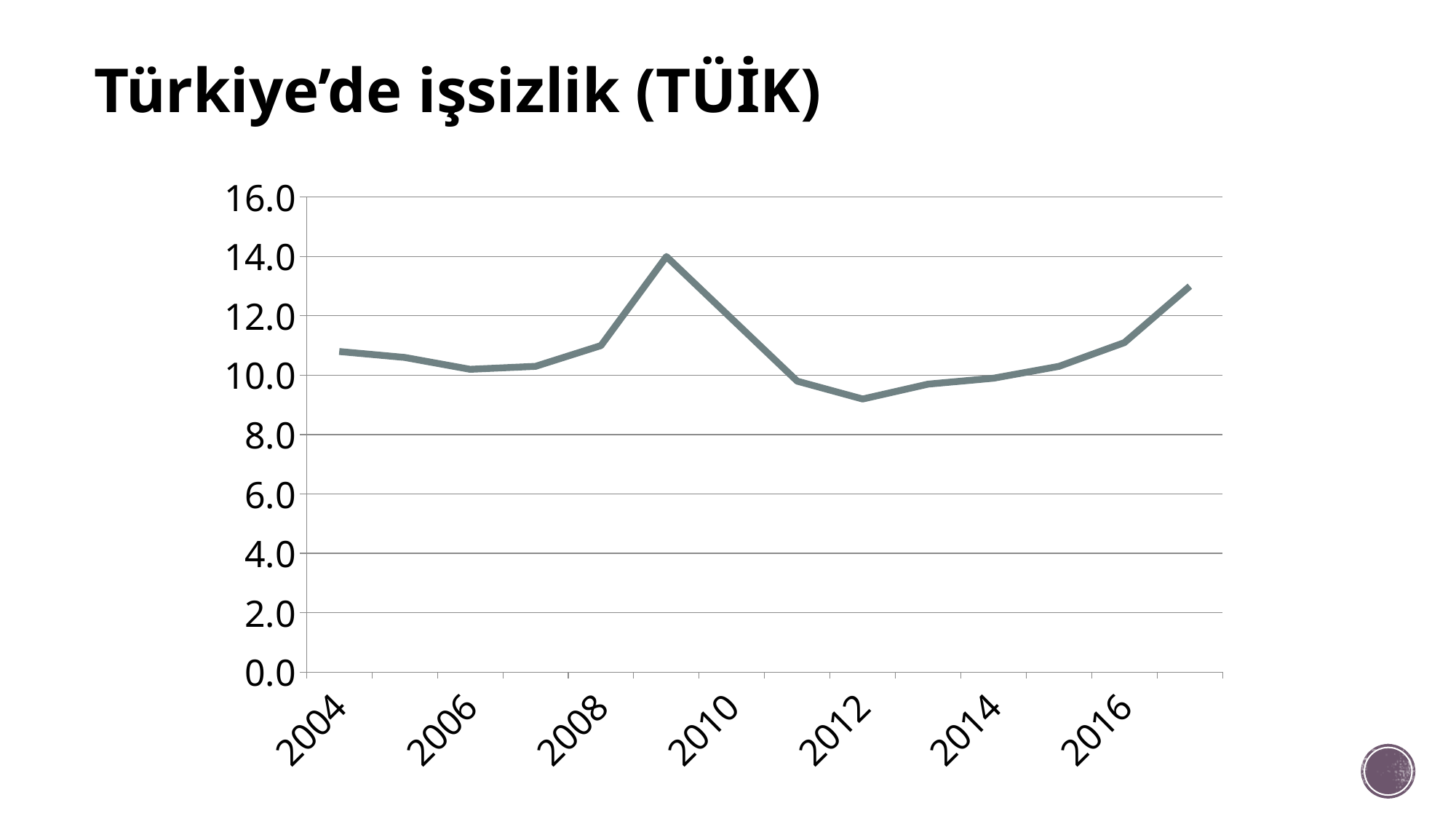
Is the value for 2012 greater or less than 10.0? less Which year has the larger value, 2009 or 2004? 2009 In which year does the line reach its highest value? 2009 Which year has the larger value, 2004 or 2012? 2004 What is the title of the chart on the slide? Türkiye'de işsizlik (TÜİK) Is the value for 2009 greater or less than 12.0? greater Is the value for 2006 greater or less than 12.0? less What kind of chart is shown on the slide? line chart How many year labels are shown on the x axis? 7 In which year does the line reach its lowest value? 2012 Does the line rise or fall between 2012 and the last point on the chart? rise